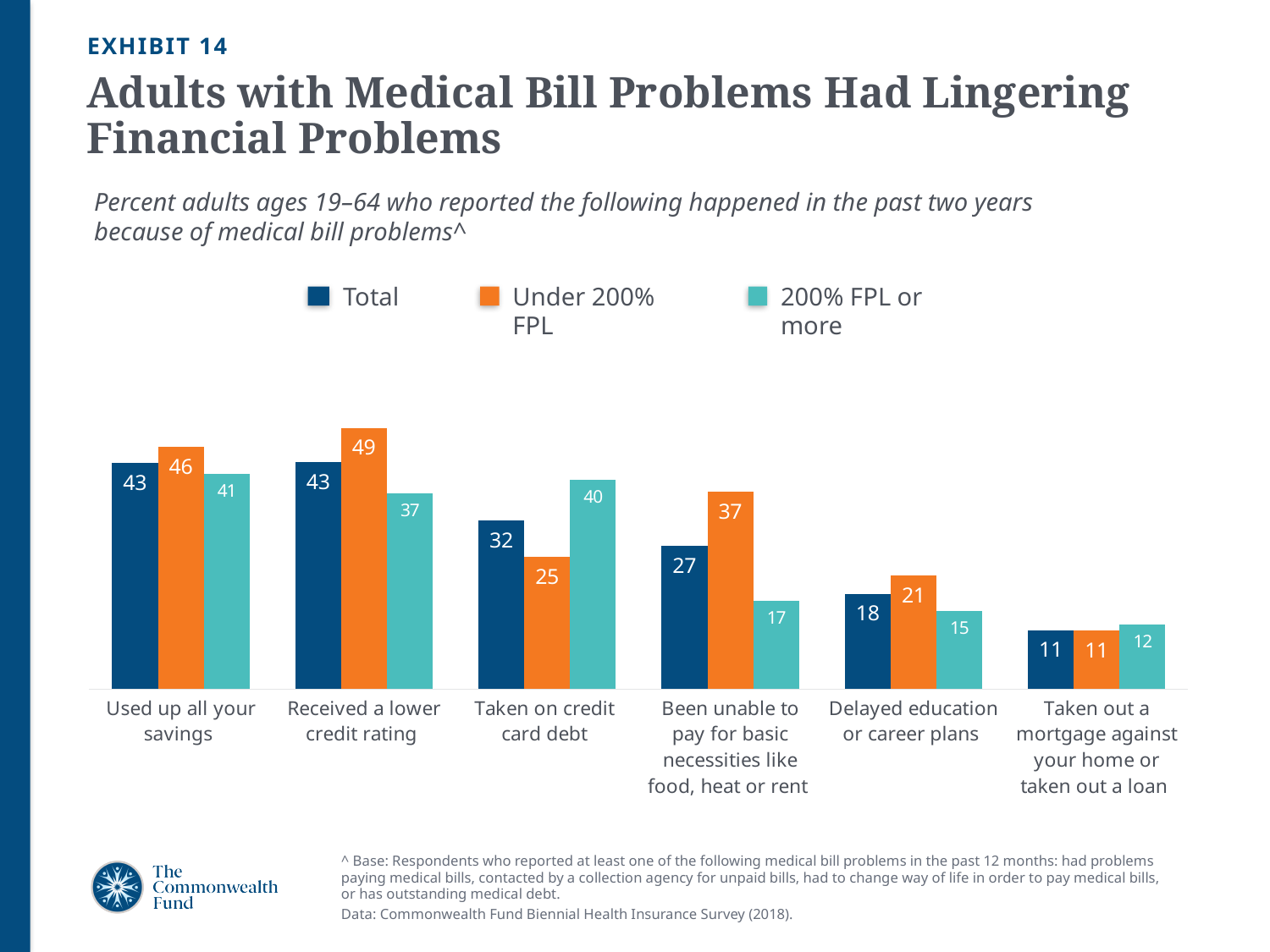
What kind of chart is shown on the slide? Bar chart Which category has the highest "Under 200% FPL" value? Received a lower credit rating What is the value for "200% FPL or more" for "Taken on credit card debt"? 40 For "Taken on credit card debt", which is larger: the "Under 200% FPL" value or the "200% FPL or more" value? 200% FPL or more Which series is shown in orange in the legend? Under 200% FPL What is the Total value for "Received a lower credit rating"? 43 How many series does the legend list? 3 What is the "Under 200% FPL" value for "Been unable to pay for basic necessities like food, heat or rent"? 37 What is the difference between the "Under 200% FPL" and "200% FPL or more" values for "Been unable to pay for basic necessities like food, heat or rent"? 20 Do the Total values rise or fall moving from left to right across the categories? Fall How many categories are shown on the x axis? 6 Which category has the lowest Total value? Taken out a mortgage against your home or taken out a loan